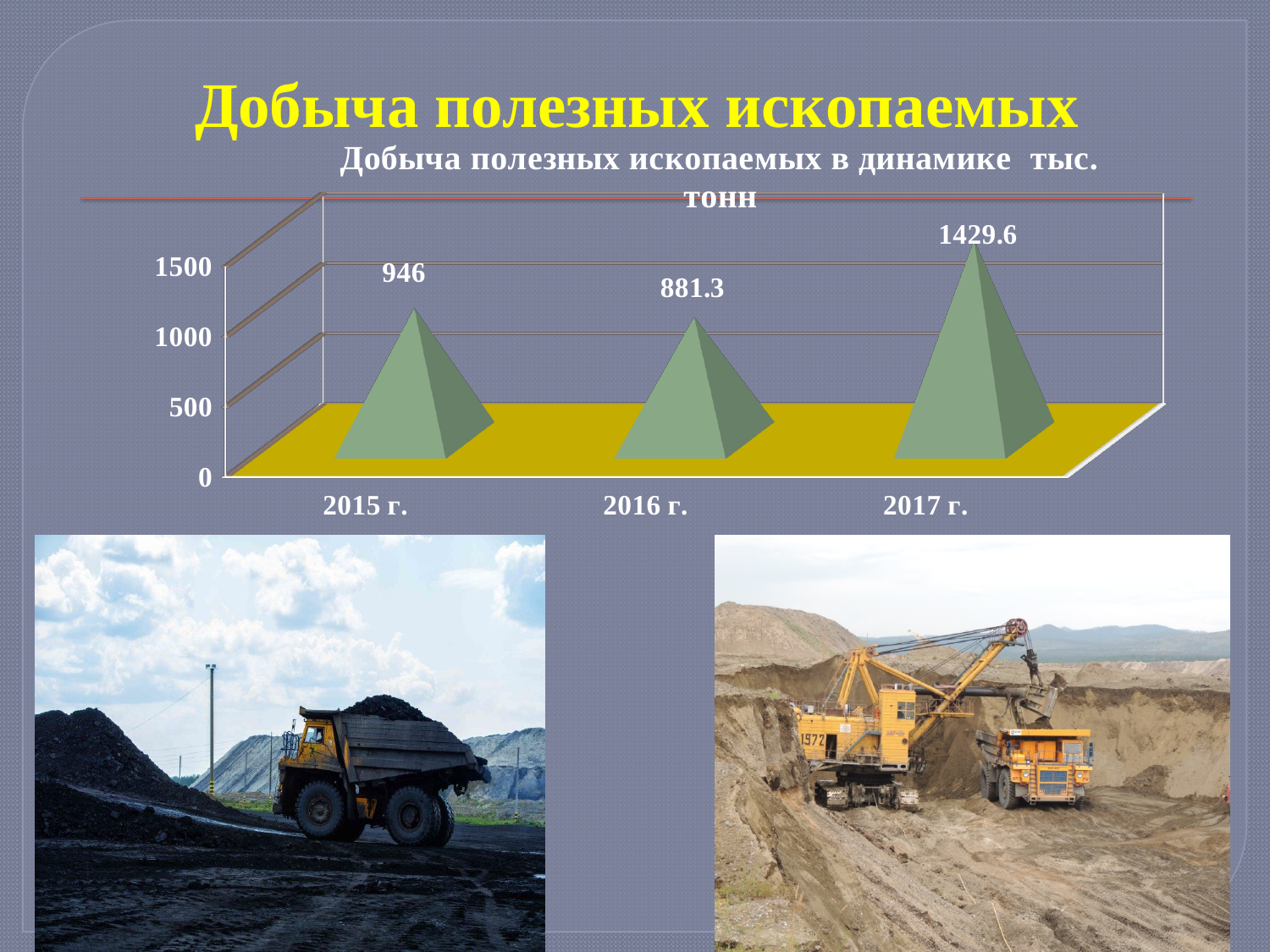
How many years are shown on the x axis? 3 Is the value for 2017 г. greater or less than 1000? greater What is the title of the chart? Добыча полезных ископаемых в динамике тыс. тонн What is the difference between the values for 2017 г. and 2015 г.? 483.6 Which year has the highest value? 2017 г. What is the value for 2017 г.? 1429.6 What is the value for 2015 г.? 946 What kind of chart is shown on the slide? bar chart Which year has the lowest value? 2016 г. What is the value for 2016 г.? 881.3 Which is larger, the value for 2015 г. or the value for 2016 г.? 2015 г. What is the difference between the values for 2015 г. and 2016 г.? 64.7